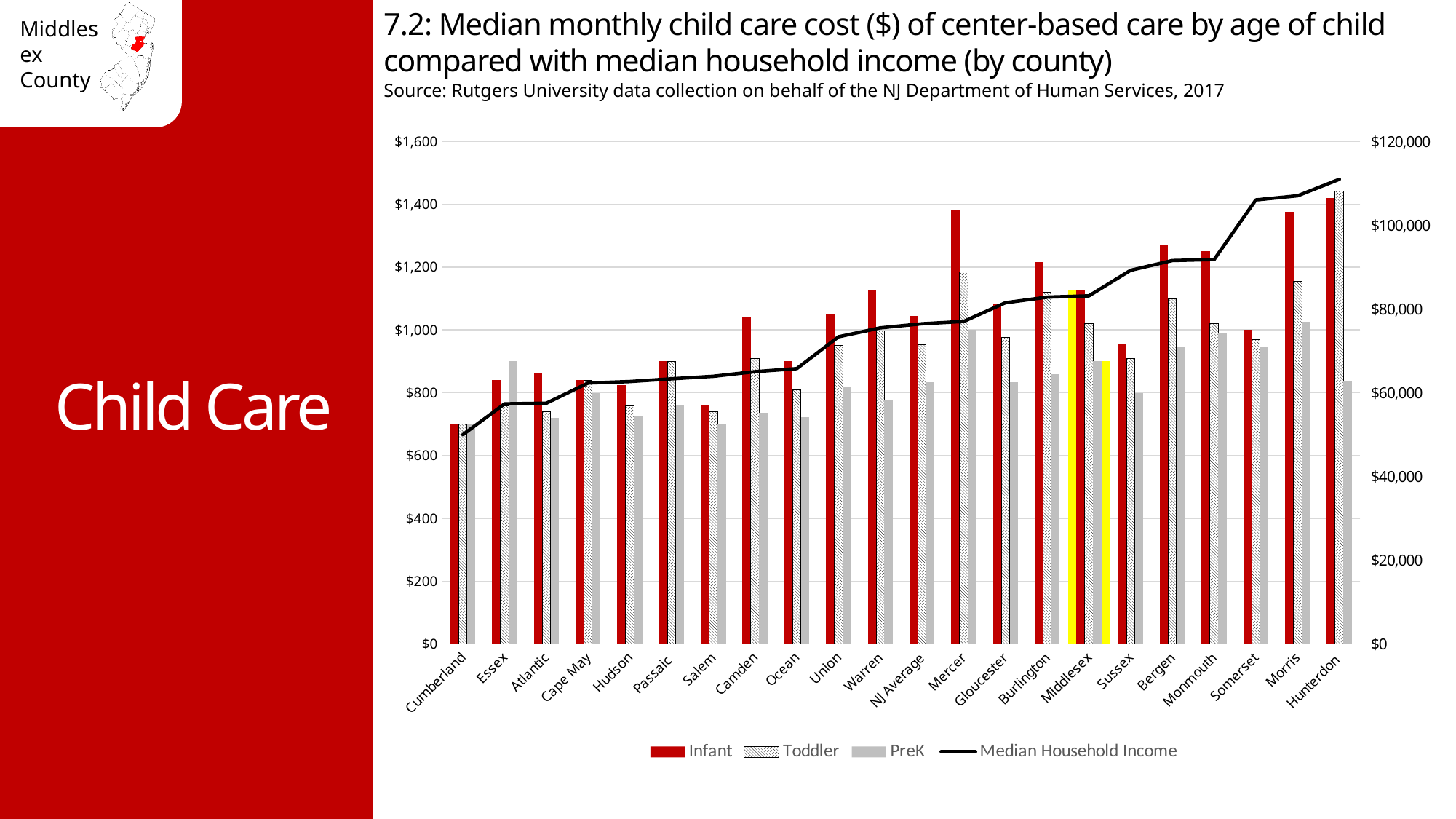
Which category has the lowest Infant cost? Cumberland What kind of chart is shown on the slide? Bar chart with a line Is the Median Household Income for Hunterdon greater or less than $100,000? greater Is the Median Household Income for Cumberland greater or less than $60,000? less How many categories are shown along the x axis? 22 For Essex, which is larger: the Infant cost or the PreK cost? PreK How many series does the legend list? 4 Is the Infant cost for Cumberland greater or less than $800? less Which county's bars are highlighted in yellow? Middlesex Which category has the highest Toddler cost? Hunterdon Does the Median Household Income line generally rise or fall from Cumberland to Hunterdon? Rise